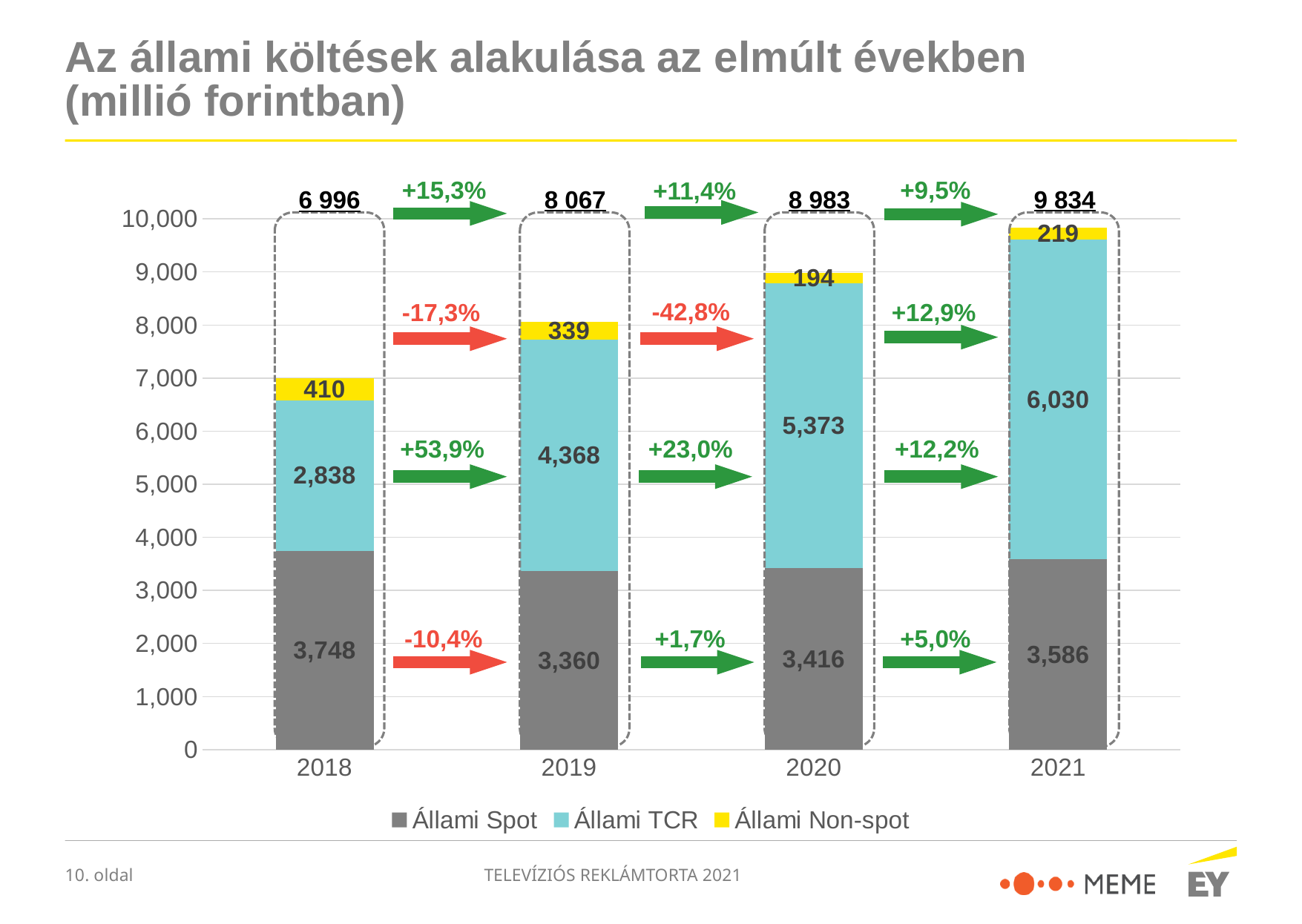
What is the value of Állami Non-spot in 2019? 339 What is the value of Állami Spot in 2018? 3,748 Is the value of Állami TCR larger in 2019 or in 2020? 2020 Do the total values of the stacked bars rise or fall from 2018 to 2021? Rise Which year has the lowest value for Állami Non-spot? 2020 Which year has the highest value for Állami TCR? 2021 How many years are shown on the x axis? 4 What is the total of the stacked bar for 2020? 8 983 What is the difference between Állami Spot in 2018 and in 2019? 388 How many series does the legend list? 3 What kind of chart is shown on the slide? Stacked bar chart What is the value of Állami TCR in 2021? 6,030